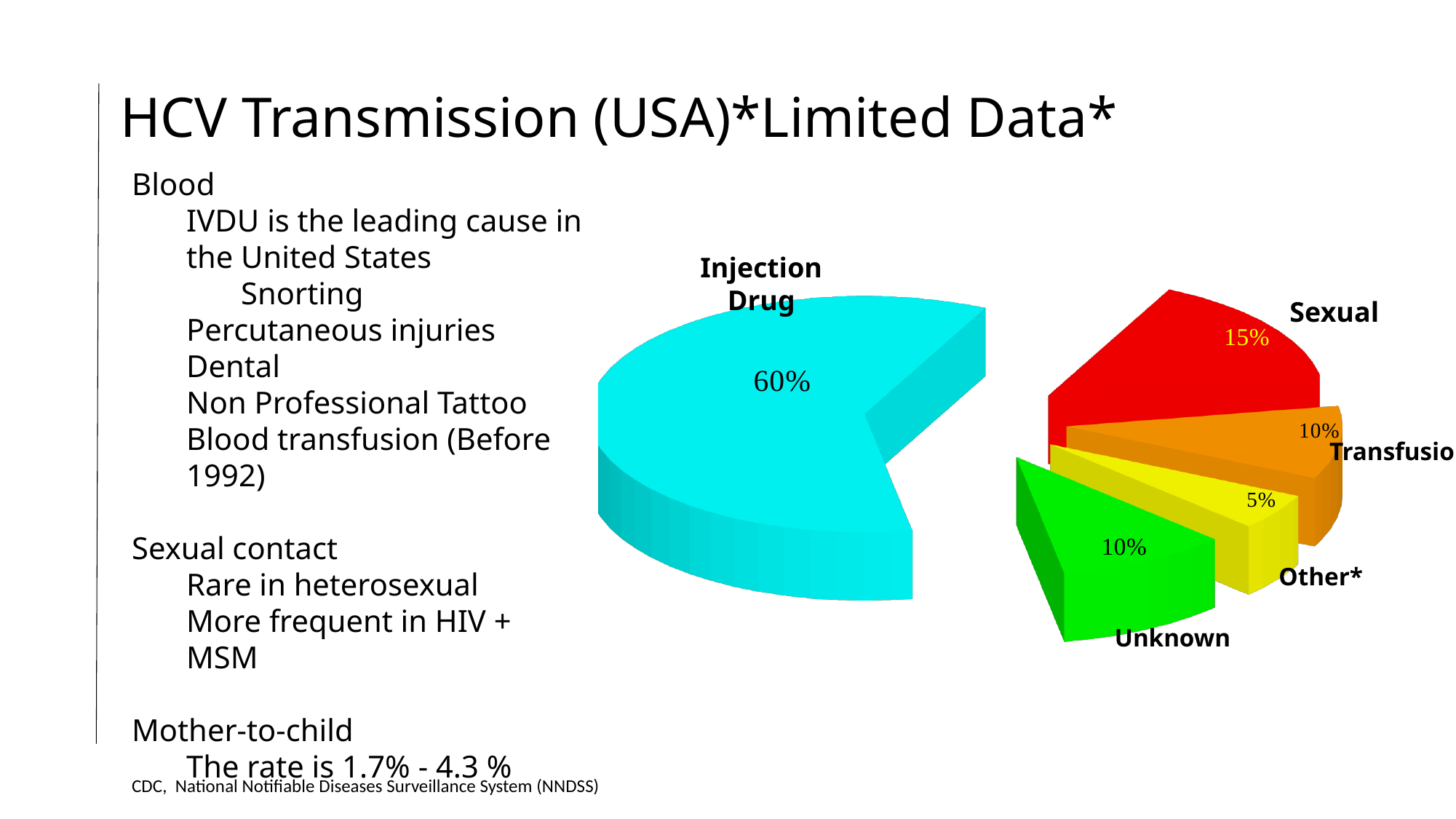
Which category has the smallest slice in the pie chart? Other* What kind of chart is shown on the slide? pie chart What percentage does the Sexual slice represent in the pie chart? 15% What colour is the Injection Drug slice in the pie chart? cyan What is the difference in percentage points between the Sexual slice and the Other* slice? 10 What percentage does the Unknown slice represent in the pie chart? 10% What is the difference in percentage points between the Injection Drug slice and the Sexual slice? 45 What percentage does the Other* slice represent in the pie chart? 5% Which slice is larger in the pie chart, Sexual or Unknown? Sexual What percentage of HCV transmission is attributed to Injection Drug use in the pie chart? 60% How many slices does the pie chart have? 5 Which category has the largest slice in the pie chart? Injection Drug